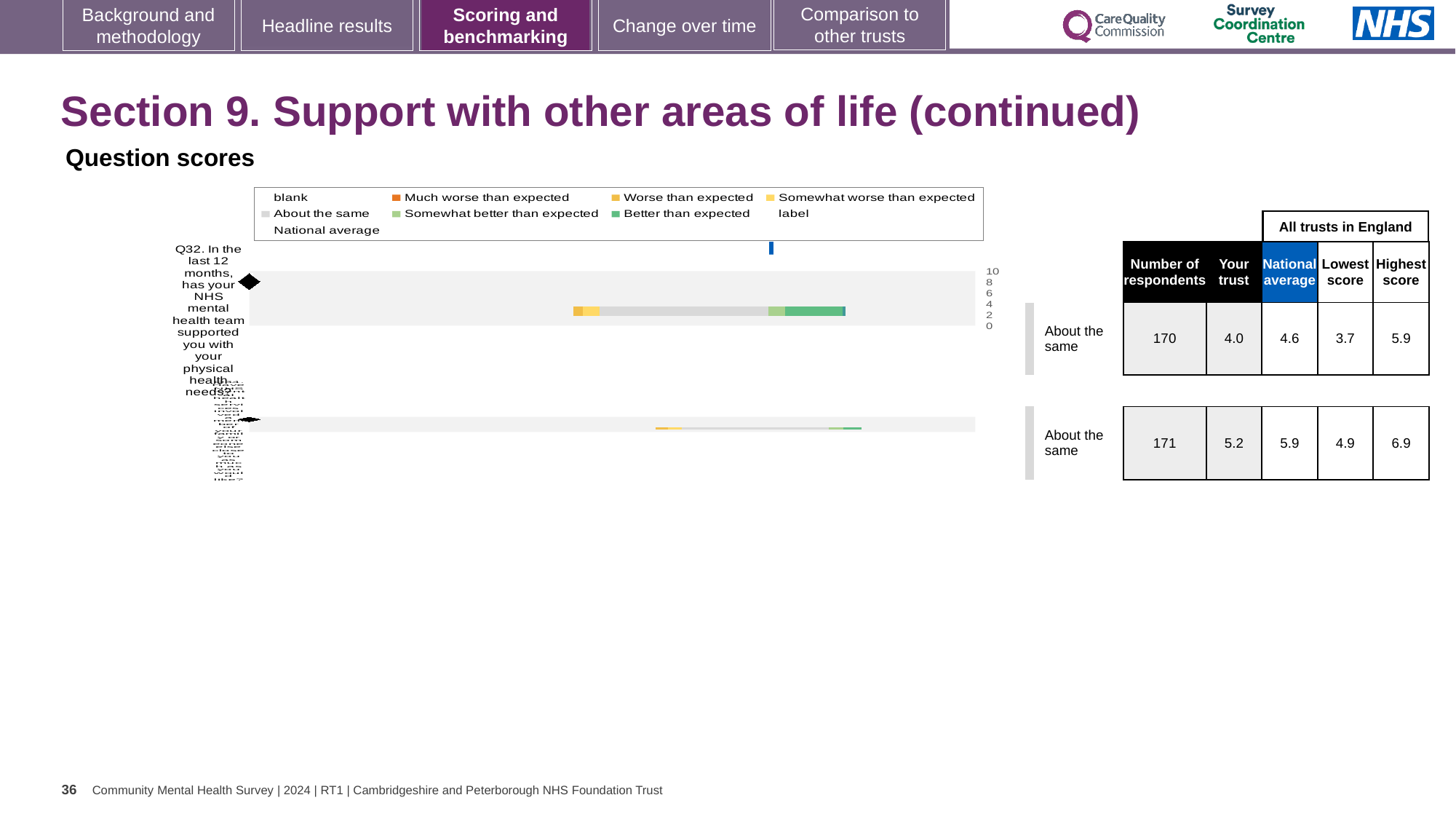
What is the national average score for Q32 (support with physical health needs)? 4.6 What is the 'Your trust' score for the second (lower) question row? 5.2 What is the 'Your trust' score for Q32 (support with physical health needs)? 4.0 How many entries does the chart legend list? 9 What benchmark category is shown for both question rows? About the same What is the lowest score among all trusts in England for the second (lower) question row? 4.9 What kind of chart is shown on the slide? bar chart How many question bars are plotted in the chart? 2 What is the difference between the national average and the 'Your trust' score for Q32 (support with physical health needs)? 0.6 What is the highest score among all trusts in England for Q32 (support with physical health needs)? 5.9 How many respondents answered Q32 (support with physical health needs)? 170 Which is larger for the second (lower) question row: the 'Your trust' score or the national average? National average